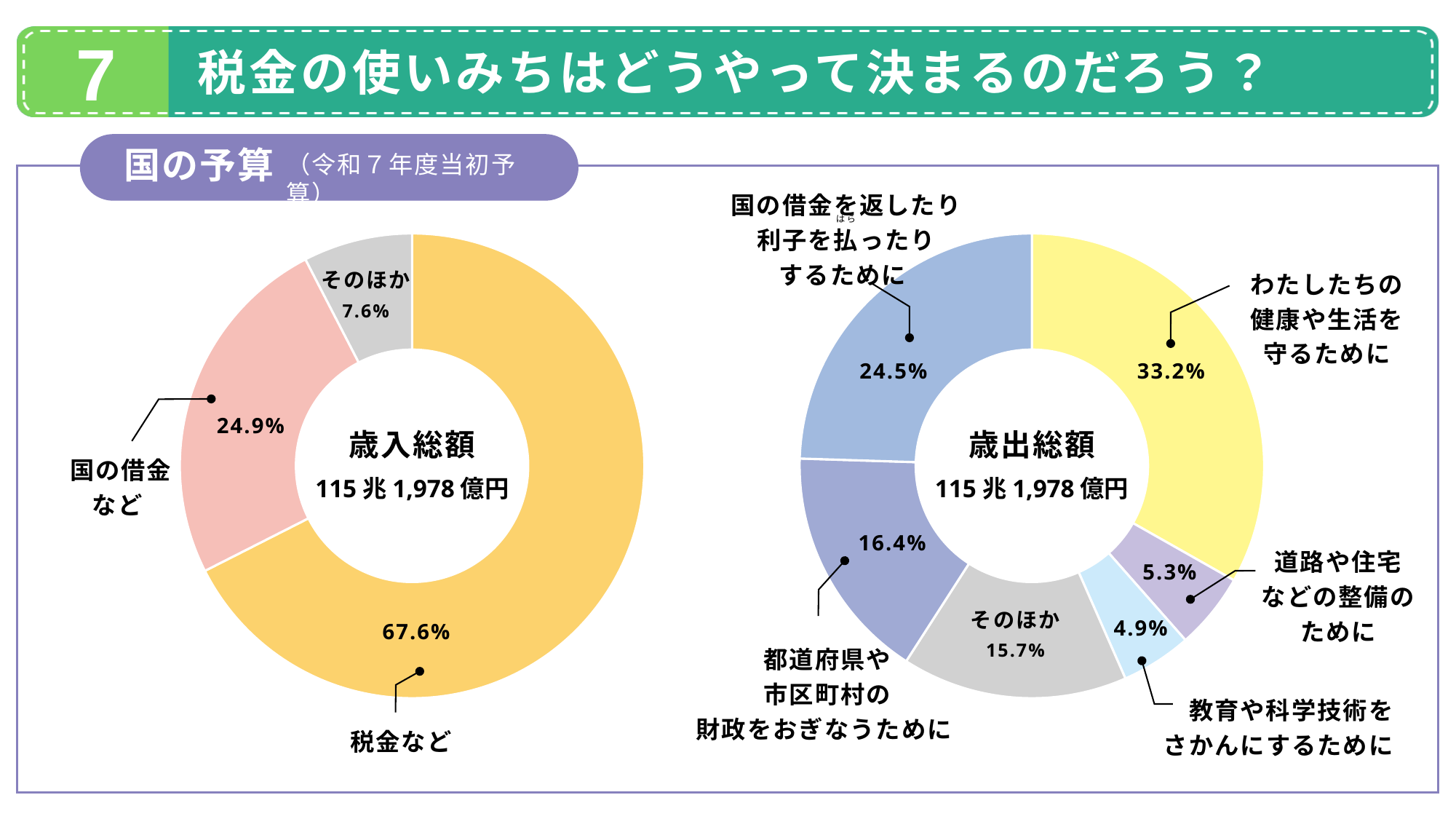
In the 歳出総額 chart, what share is labelled for 都道府県や市区町村の財政をおぎなうために? 16.4% What total amount is shown in the centre of the 歳出総額 chart? 115兆1,978億円 In the 歳入総額 chart, what is the difference between the shares for 税金など and 国の借金など? 42.7% In the 歳入総額 chart, how many slices are there? 3 In the 歳出総額 chart, which category has the largest share? わたしたちの健康や生活を守るために In the 歳入総額 chart, what share is labelled for 国の借金など? 24.9% In the 歳入総額 chart, what share is labelled for 税金など? 67.6% In the 歳出総額 chart, which category has the smallest share? 教育や科学技術をさかんにするために What kind of chart is the 歳出総額 chart? Donut (pie) chart In the 歳出総額 chart, which is larger: 国の借金を返したり利子を払ったりするために or そのほか? 国の借金を返したり利子を払ったりするために In the 歳出総額 chart, what share is labelled for わたしたちの健康や生活を守るために? 33.2% In the 歳入総額 chart, which category has the smallest share? そのほか